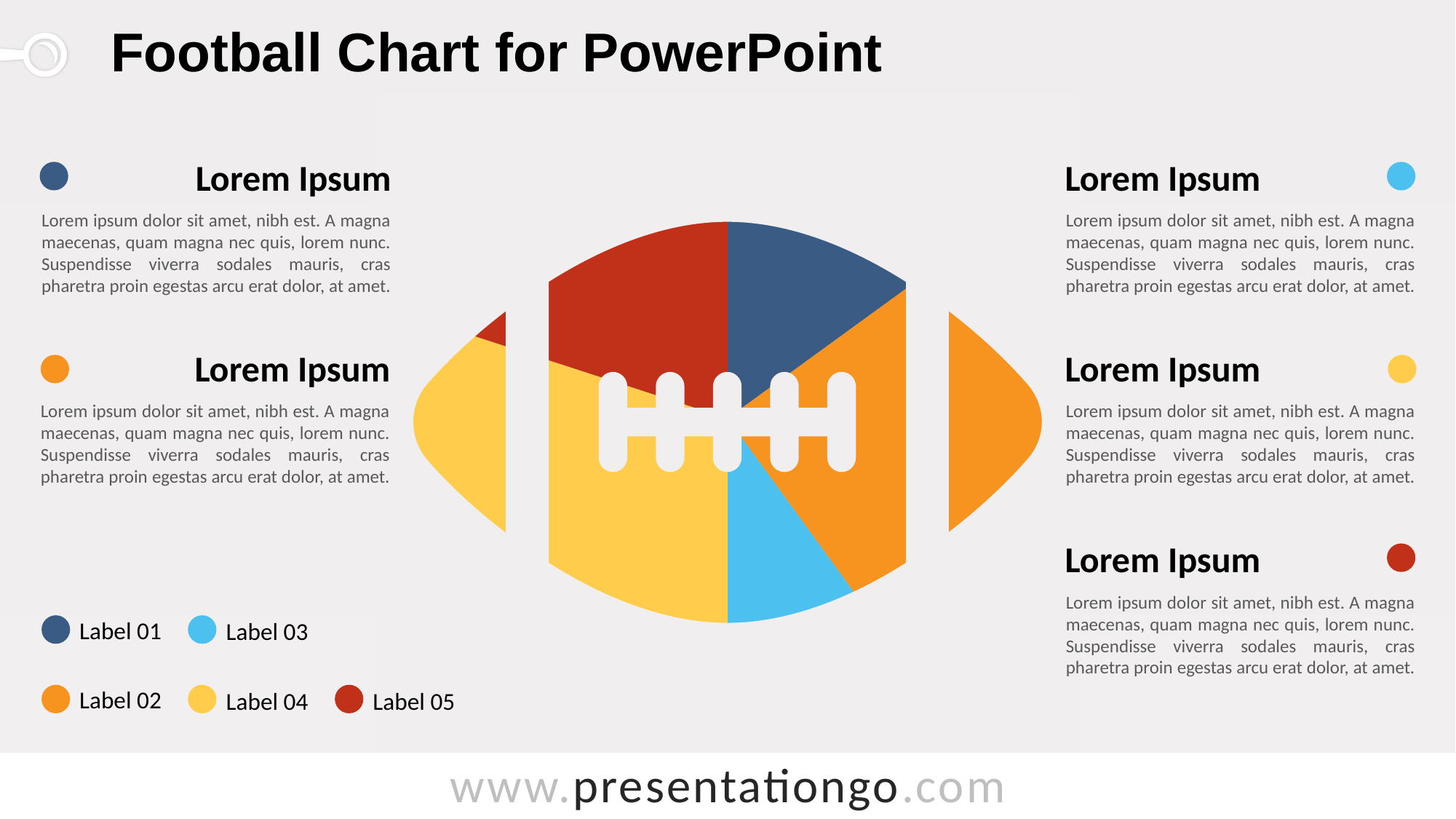
How many slices does the football-shaped chart have? 5 Which slice is larger, Label 01 or Label 03? Label 01 What kind of chart is shown on the slide? pie chart What is the title of the slide? Football Chart for PowerPoint How many labels does the legend list? 5 Which slice is larger, Label 04 or Label 03? Label 04 What colour is the slice for Label 05? red Which label has the smallest slice in the chart? Label 03